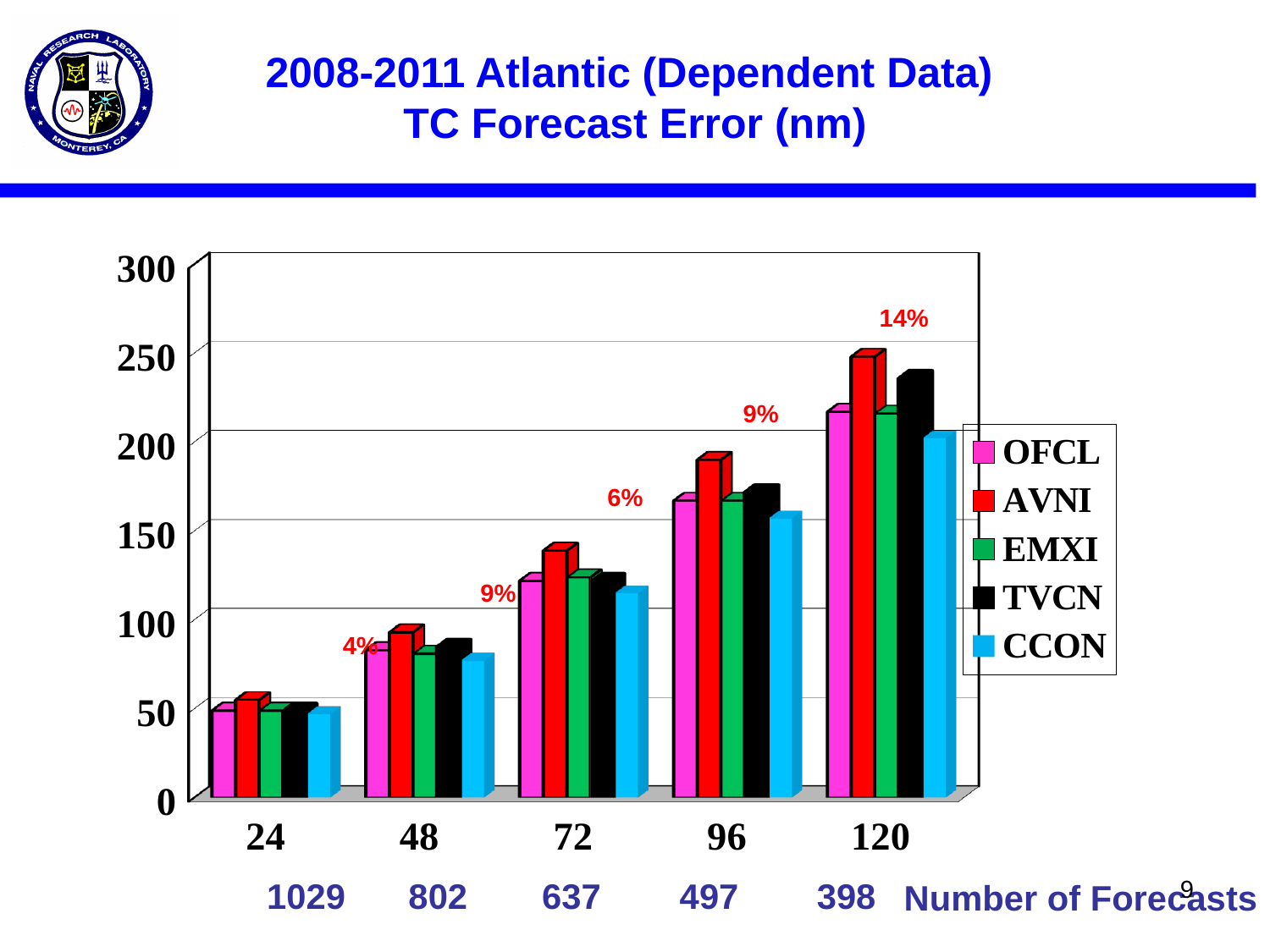
Is the value for TVCN at 72 hours greater or less than 150? less What is the number of forecasts shown for the 24-hour lead time? 1029 What kind of chart is shown on the slide? bar chart How many forecast lead-time categories are shown on the x axis? 5 Do the forecast errors rise or fall as the lead time increases from 24 to 120 hours? rise What percentage label is printed above the 120-hour group of bars? 14% Is the value for AVNI at 120 hours greater or less than 200? greater How many series does the legend list? 5 At 96 hours, which has the larger forecast error, AVNI or CCON? AVNI Which series has the highest forecast error at 120 hours? AVNI Is the value for CCON at 24 hours greater or less than 100? less Which series has the lowest forecast error at 120 hours? CCON